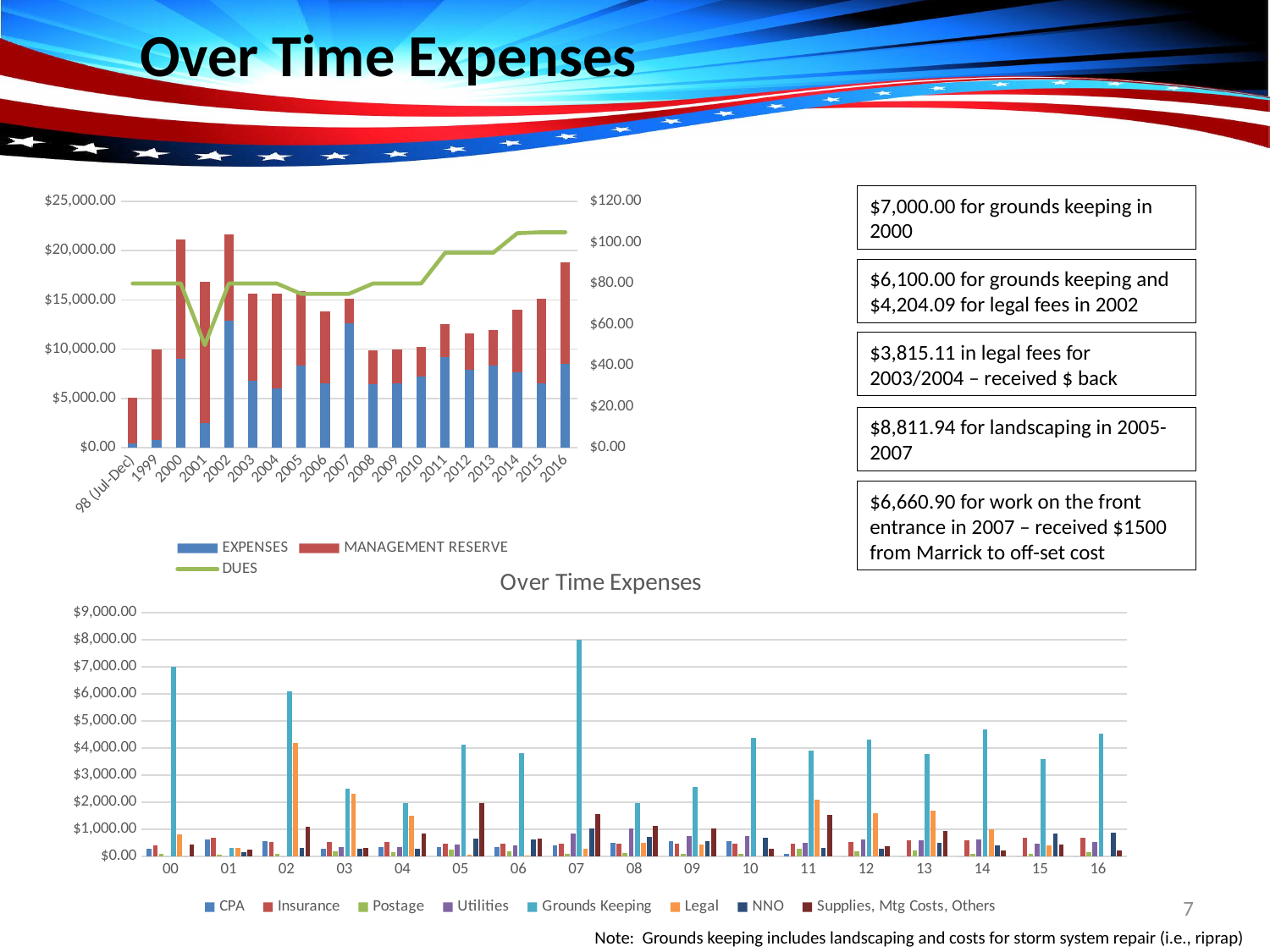
What kind of chart is the bottom chart titled 'Over Time Expenses'? Bar chart On the bottom chart titled 'Over Time Expenses', which is larger in 14: Grounds Keeping or Legal? Grounds Keeping On the top-left chart, which category has the lowest total stacked bar? 98 (Jul-Dec) On the bottom chart titled 'Over Time Expenses', how many series does the legend list? 8 On the top-left chart, is the DUES value for 2016 greater or less than $100.00? greater On the bottom chart titled 'Over Time Expenses', is the Grounds Keeping value for 07 greater or less than $7,000.00? greater On the bottom chart titled 'Over Time Expenses', in which year is the Grounds Keeping value highest? 07 On the top-left chart, how many categories are shown on the x axis? 19 On the bottom chart titled 'Over Time Expenses', how many year categories are shown on the x axis? 17 On the bottom chart titled 'Over Time Expenses', is the Grounds Keeping value for 02 greater or less than $5,000.00? greater On the top-left chart, how many entries does the legend list? 3